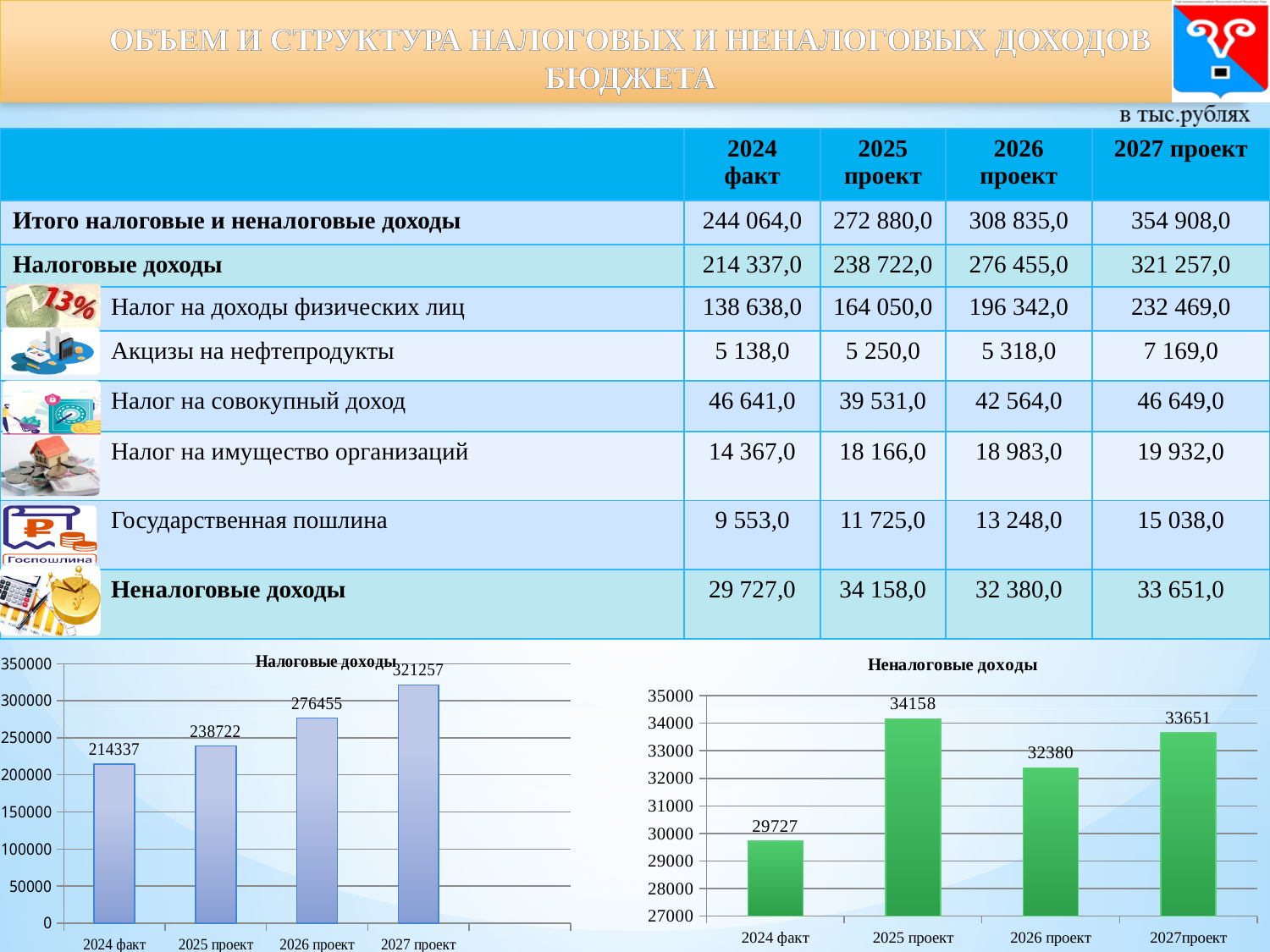
In the "Неналоговые доходы" chart, what is the value for 2026 проект? 32380 What kind of chart is the "Налоговые доходы" chart? bar chart In the "Налоговые доходы" chart, do the values rise or fall from 2024 факт to 2027 проект? rise In the "Неналоговые доходы" chart, which category has the highest value? 2025 проект In the "Налоговые доходы" chart, what is the difference between the values for 2027 проект and 2024 факт? 106920 In the "Неналоговые доходы" chart, which is larger: the value for 2026 проект or the value for 2027проект? 2027проект In the "Налоговые доходы" chart, is the value for 2026 проект greater or less than 250000? greater In the "Налоговые доходы" chart, which category has the lowest value? 2024 факт In the "Неналоговые доходы" chart, what is the difference between the values for 2025 проект and 2024 факт? 4431 In the "Налоговые доходы" chart, what is the value for 2025 проект? 238722 How many bars are shown in the "Неналоговые доходы" chart? 4 What is the title of the chart on the right side of the slide? Неналоговые доходы